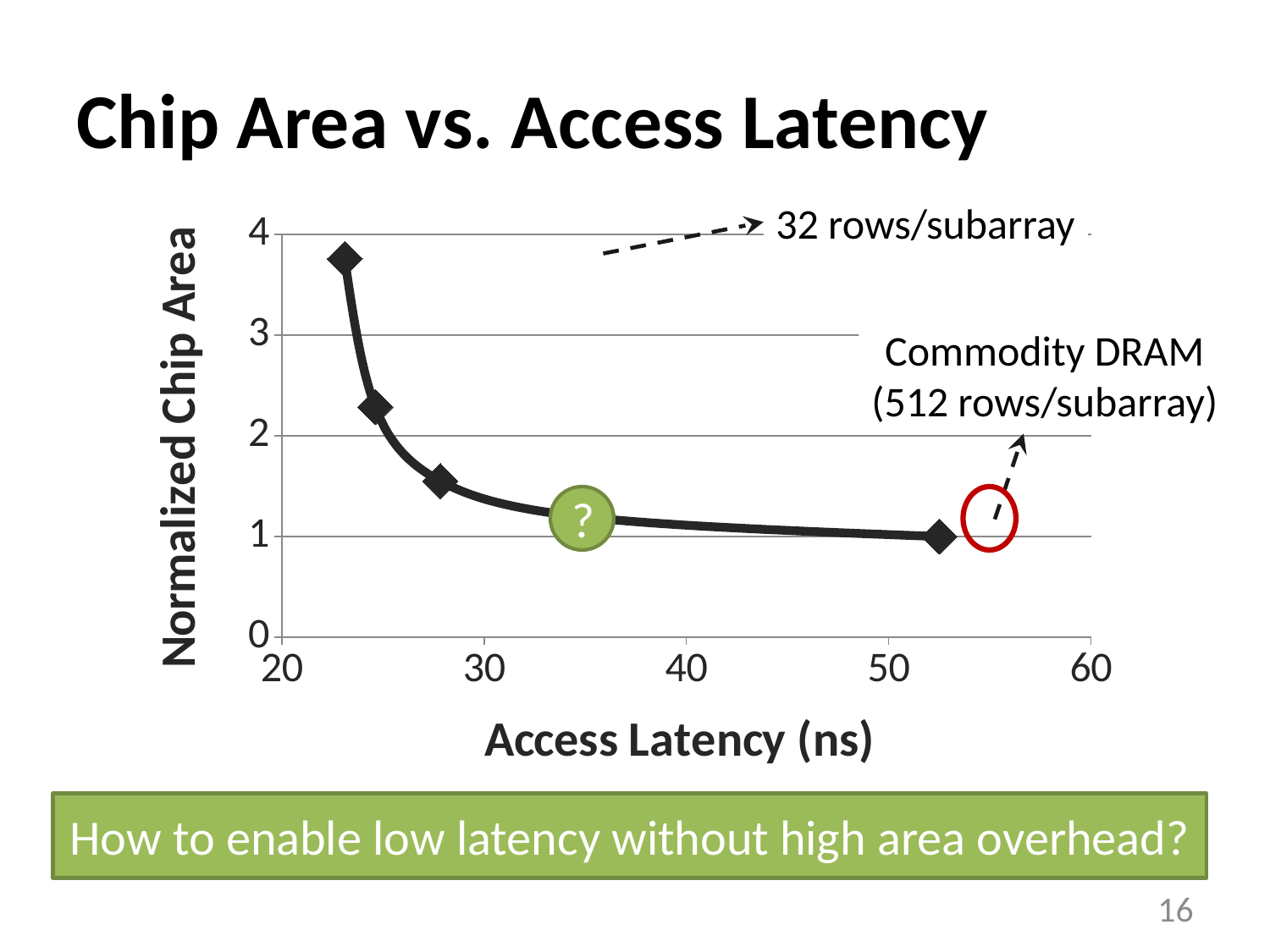
Is the normalized chip area of the Commodity DRAM (512 rows/subarray) point greater or less than 2? less What is the title of the chart? Chip Area vs. Access Latency Is the access latency of the Commodity DRAM (512 rows/subarray) point greater or less than 50 ns? greater How many data points (diamond markers) are plotted on the chart? 5 Is the access latency of the 32 rows/subarray point greater or less than 30 ns? less As access latency increases along the x axis, does normalized chip area rise or fall? fall What kind of chart is shown on the slide? line chart Which labeled point has the highest normalized chip area, 32 rows/subarray or Commodity DRAM (512 rows/subarray)? 32 rows/subarray What is the label of the x axis? Access Latency (ns) Which labeled point has the lowest access latency, 32 rows/subarray or Commodity DRAM (512 rows/subarray)? 32 rows/subarray